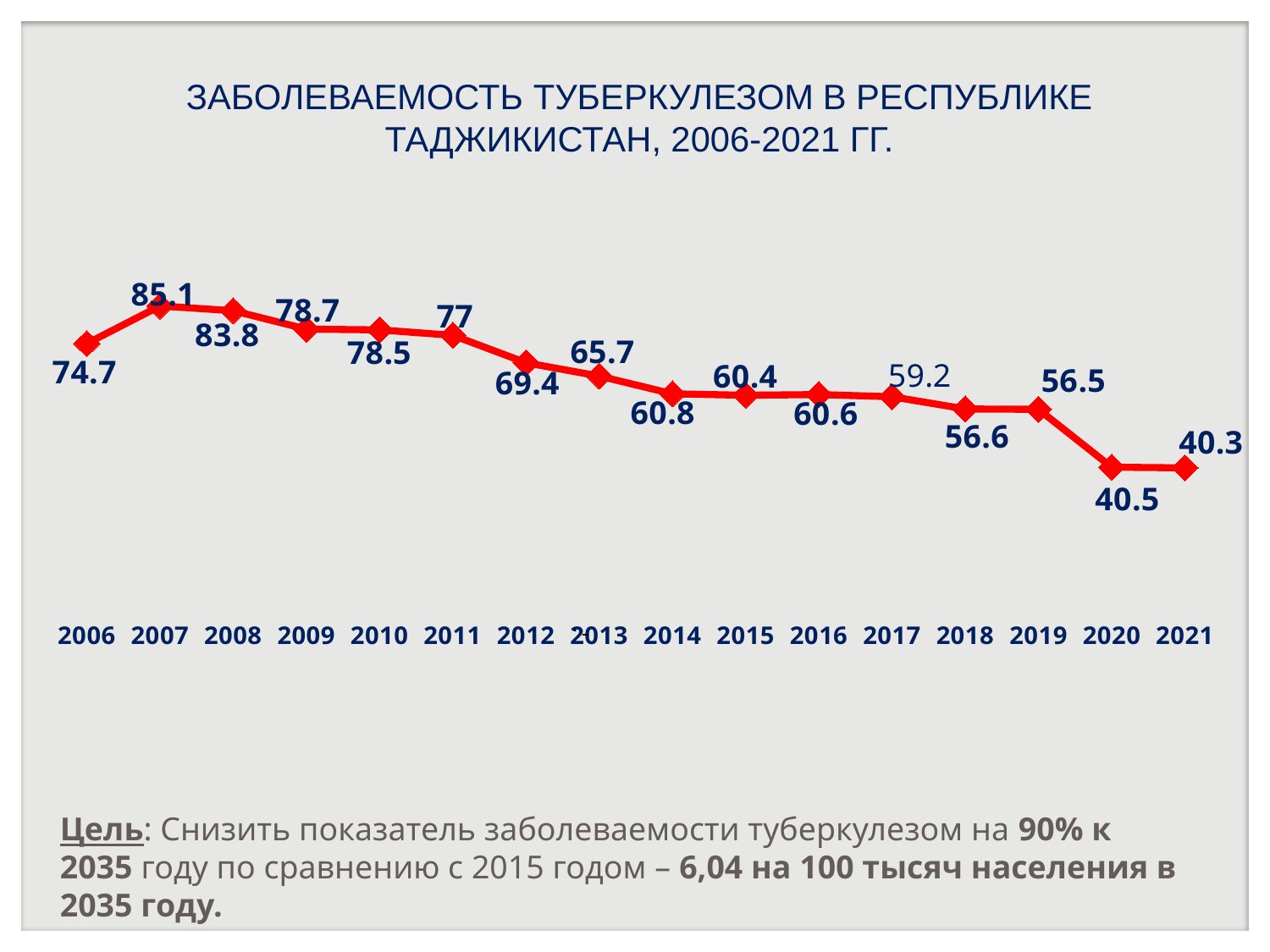
Do the values generally rise or fall from 2007 to 2021? Fall How many years (data points) are plotted on the chart? 16 Which year has the lowest value on the chart? 2021 Which year has the highest value on the chart? 2007 What is the difference between the values for 2019 and 2020? 16 What is the value plotted for 2021? 40.3 What is the value plotted for 2017? 59.2 What type of chart is shown on the slide? Line chart Which year has the larger value, 2012 or 2013? 2012 What is the value plotted for 2011? 77 What is the difference between the values for 2007 and 2006? 10.4 What is the tuberculosis incidence value for 2006? 74.7